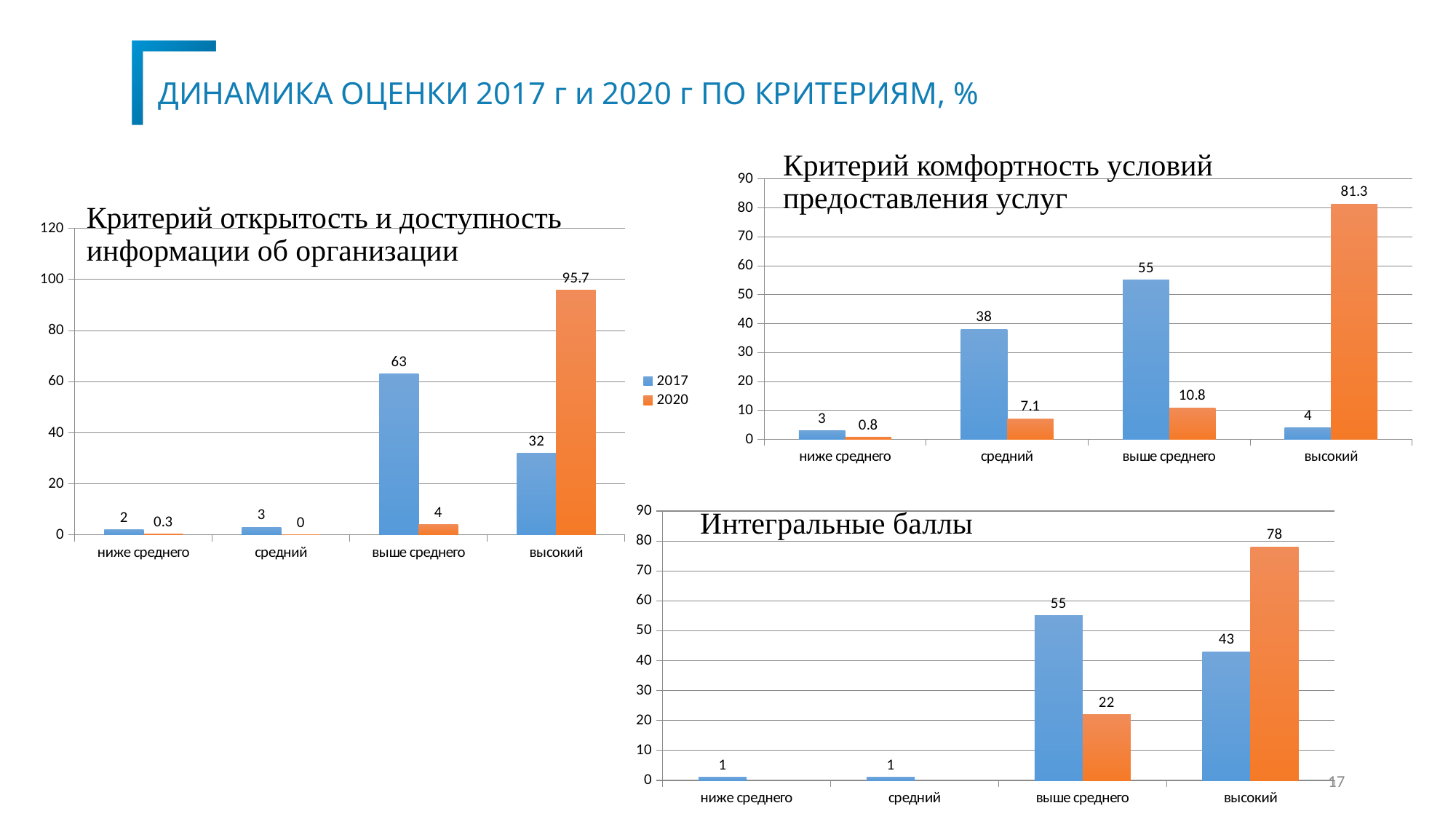
In the chart 'Критерий комфортность условий предоставления услуг', which is larger for 'выше среднего': the 2017 value or the 2020 value? 2017 In the chart 'Критерий комфортность условий предоставления услуг', what is the 2020 value for 'средний'? 7.1 In the chart 'Критерий комфортность условий предоставления услуг', what is the difference between the 2020 and 2017 values for 'высокий'? 77.3 In the chart 'Критерий открытость и доступность информации об организации', what is the 2020 value for 'высокий'? 95.7 In the chart 'Интегральные баллы', what is the 2020 value for 'высокий'? 78 In the chart 'Критерий комфортность условий предоставления услуг', which category has the lowest 2020 value? ниже среднего In the chart 'Критерий открытость и доступность информации об организации', which category has the highest 2017 value? выше среднего In the chart 'Критерий открытость и доступность информации об организации', what is the difference between the 2017 and 2020 values for 'высокий'? 63.7 How many series does the legend on the slide list? 2 How many categories are shown on the x axis of the chart 'Интегральные баллы'? 4 In the chart 'Критерий открытость и доступность информации об организации', what is the 2017 value for 'выше среднего'? 63 In the chart 'Интегральные баллы', what is the difference between the 2017 and 2020 values for 'выше среднего'? 33